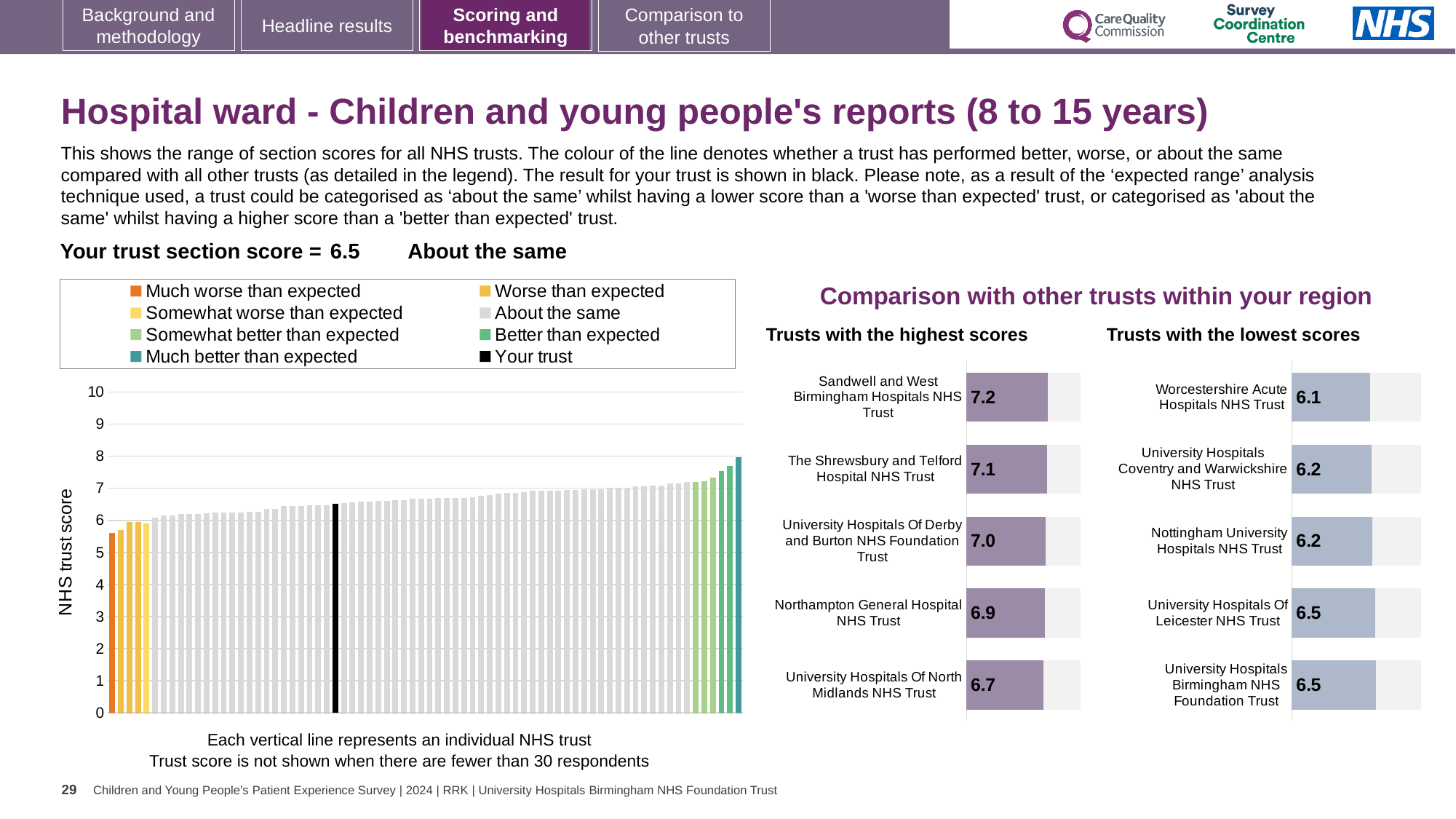
In the 'Trusts with the highest scores' chart, which trust has the highest score? Sandwell and West Birmingham Hospitals NHS Trust In the 'Trusts with the highest scores' chart, how many trusts are shown? 5 In the 'Trusts with the lowest scores' chart, which has the larger score: Worcestershire Acute Hospitals NHS Trust or University Hospitals Of Leicester NHS Trust? University Hospitals Of Leicester NHS Trust In the main 'NHS trust score' chart on the left, what kind of chart is it? Bar chart In the main 'NHS trust score' chart on the left, how many entries does the legend list? 8 In the 'Trusts with the highest scores' chart, what is the score for University Hospitals Of North Midlands NHS Trust? 6.7 In the 'Trusts with the lowest scores' chart, what is the score for Worcestershire Acute Hospitals NHS Trust? 6.1 In the 'Trusts with the lowest scores' chart, what is the difference between the scores of University Hospitals Birmingham NHS Foundation Trust and Worcestershire Acute Hospitals NHS Trust? 0.4 In the 'Trusts with the highest scores' chart, what is the score for Sandwell and West Birmingham Hospitals NHS Trust? 7.2 In the main 'NHS trust score' chart on the left, do the trust scores rise or fall from left to right? Rise In the 'Trusts with the lowest scores' chart, which trust has the lowest score? Worcestershire Acute Hospitals NHS Trust In the 'Trusts with the highest scores' chart, what is the difference between the scores of Sandwell and West Birmingham Hospitals NHS Trust and University Hospitals Of North Midlands NHS Trust? 0.5